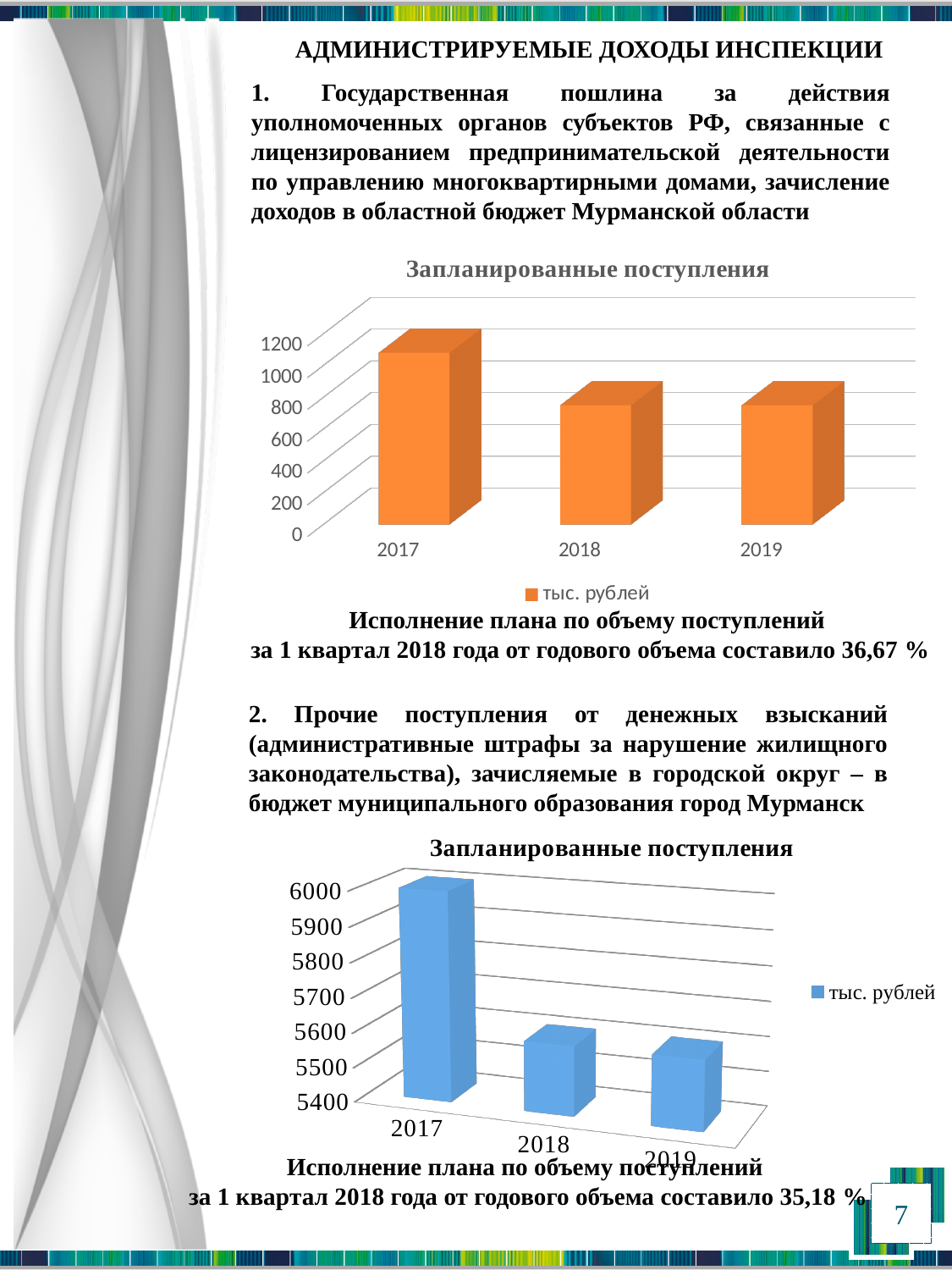
In the bottom chart (section 2), is the value for 2017 greater or less than 5900? greater In the top chart (section 1), is the value for 2019 greater or less than 600? greater What is the legend entry of the top chart (section 1)? тыс. рублей What is the title of the bottom chart (section 2)? Запланированные поступления In the bottom chart (section 2), which year has the highest planned receipts? 2017 How many series does the legend of the bottom chart (section 2) list? 1 How many years (categories) are shown in the top chart (section 1)? 3 In the top chart (section 1), which year has the highest planned receipts? 2017 In the top chart (section 1), is the value for 2017 greater or less than 1000? greater What kind of chart is the top chart on the slide (under section 1)? bar chart